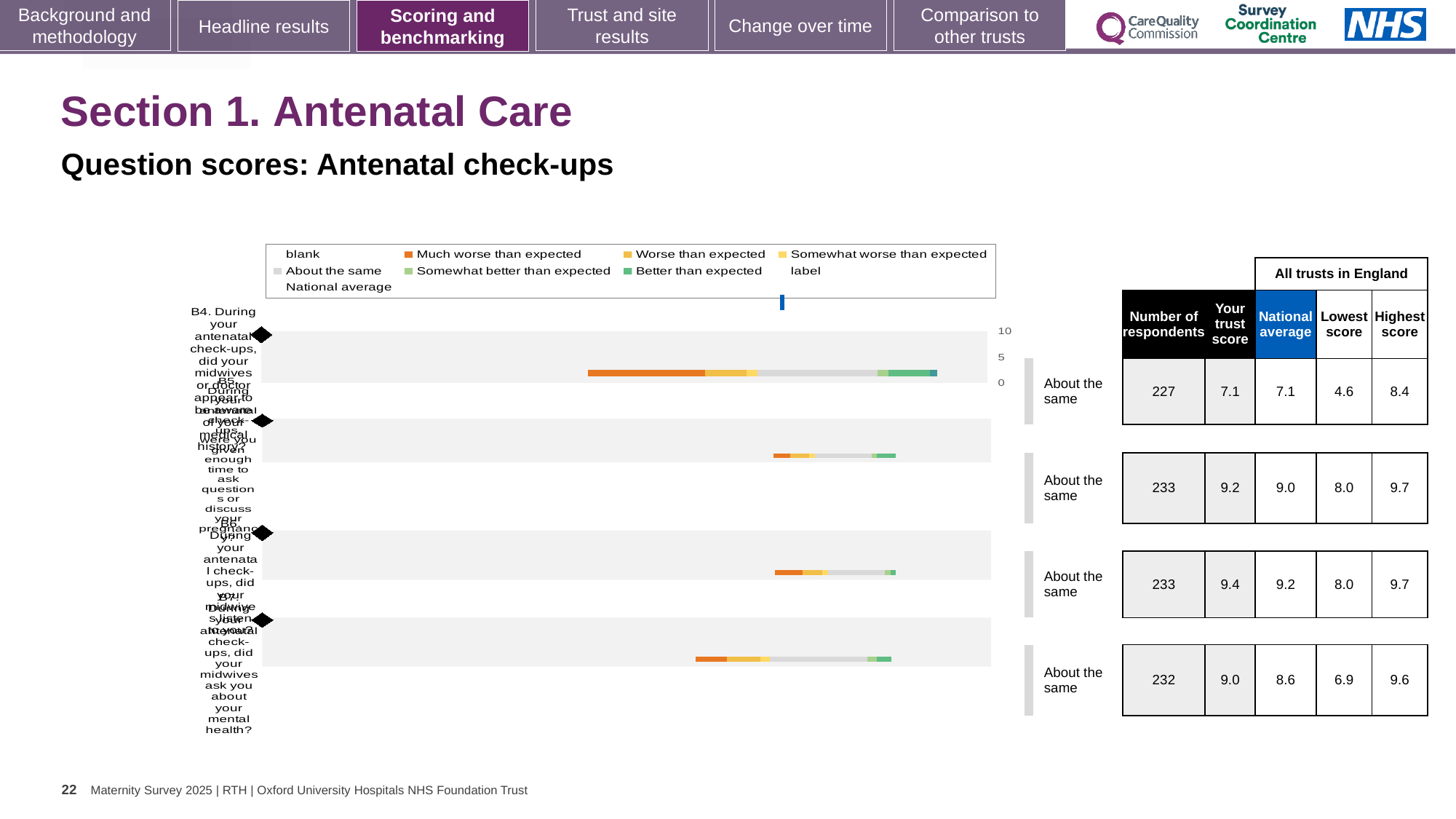
What is the highest score across all trusts in England for the fourth question (B7)? 9.6 What is the trust score for the first question (B4) in the table beside the chart? 7.1 In the chart legend, what colour represents 'Better than expected'? green How many question bars are plotted in the chart? 4 What benchmark category is shown next to each of the four question bars? About the same What is the number of respondents for the first question (B4) in the table beside the chart? 227 What is the national average for the fourth question (B7)? 8.6 Which of the four questions has the highest trust score in the table? the third question (B6), 9.4 In the chart legend, what colour represents 'Much worse than expected'? orange What kind of chart is shown on the slide? bar chart What is the difference between the trust score and the national average for the fourth question (B7)? 0.4 What is the lowest score across all trusts in England for the first question (B4)? 4.6